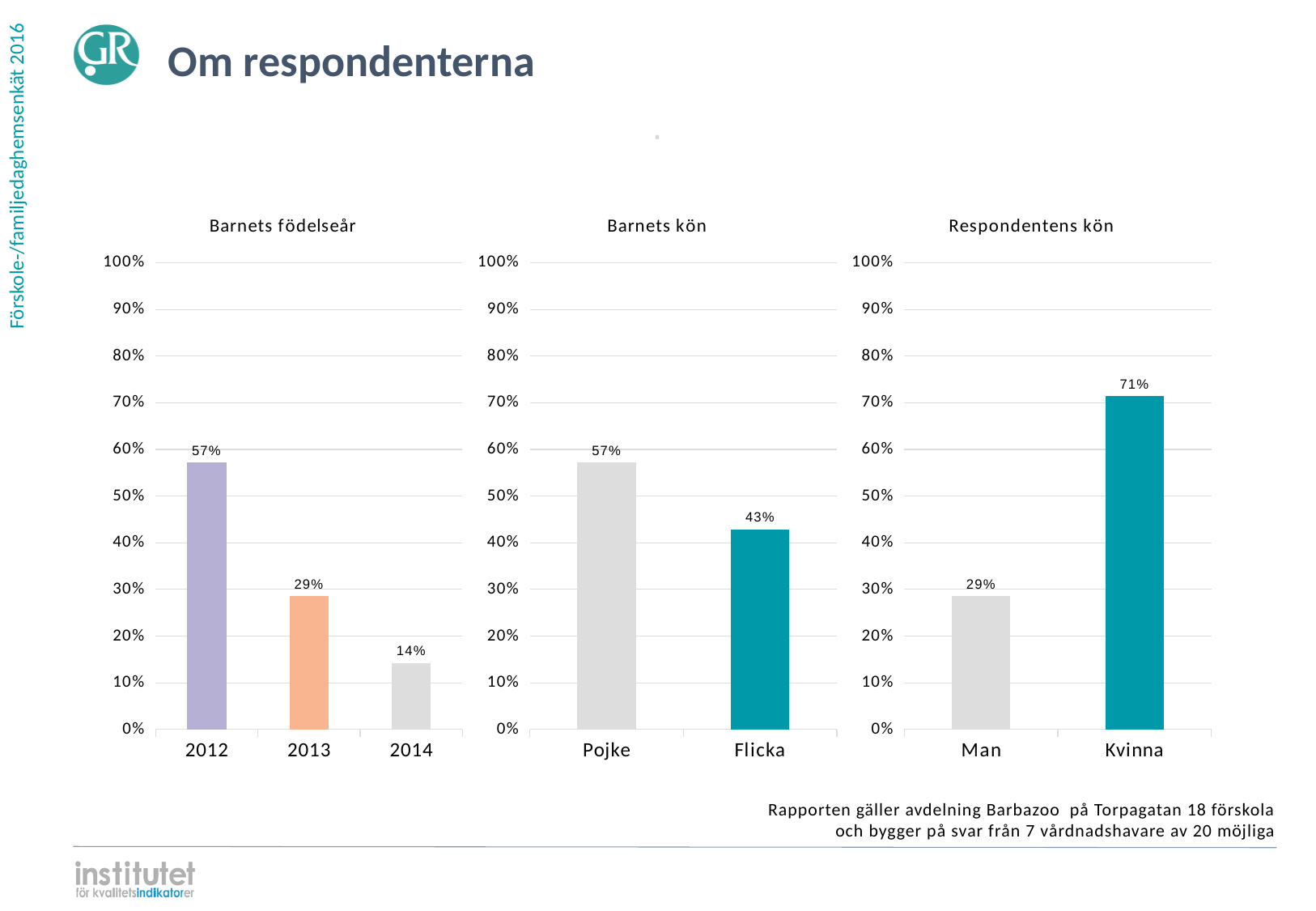
In the 'Barnets födelseår' chart, what is the value for 2014? 14% What kind of chart is the 'Respondentens kön' chart? bar chart In the 'Barnets födelseår' chart, what is the difference between the values for 2012 and 2013? 28% In the 'Barnets födelseår' chart, what is the value for 2012? 57% In the 'Barnets kön' chart, how many categories are shown? 2 In the 'Respondentens kön' chart, is the value for Man greater or less than 40%? less In the 'Barnets kön' chart, what is the value for Flicka? 43% In the 'Respondentens kön' chart, what is the value for Kvinna? 71% In the 'Respondentens kön' chart, what is the difference between the values for Kvinna and Man? 42% In the 'Barnets födelseår' chart, do the values rise or fall from 2012 to 2014? fall In the 'Barnets kön' chart, which category is higher, Pojke or Flicka? Pojke In the 'Barnets födelseår' chart, which year has the lowest value? 2014